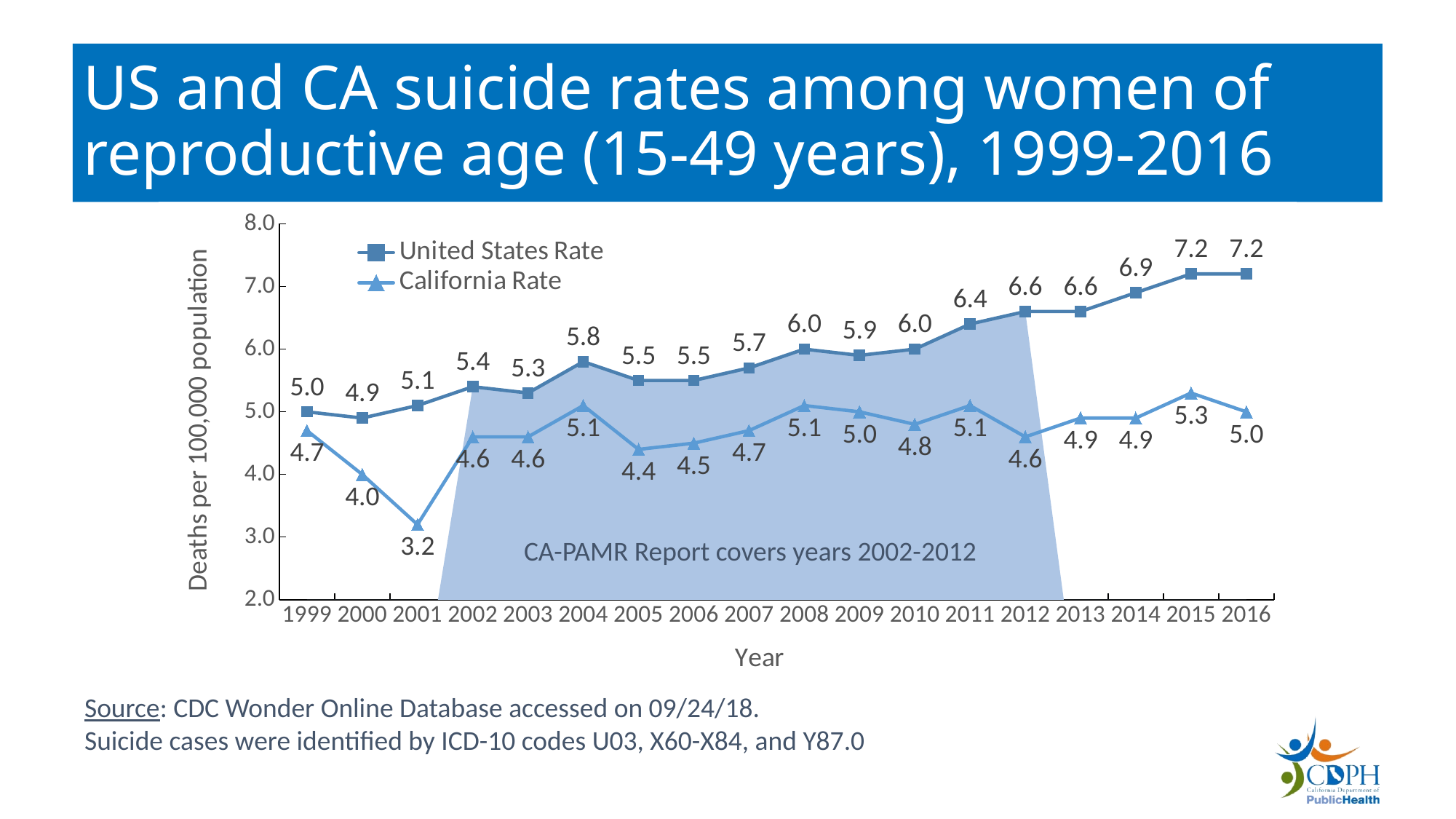
Which was higher in 2004, the United States rate or the California rate? United States Rate What was the California rate in 2001? 3.2 What kind of chart is shown on the slide? Line chart In which year was the California rate lowest? 2001 Does the United States rate generally rise or fall from 1999 to 2016? Rise What was the United States rate in 2008? 6.0 What is the highest United States rate shown on the chart? 7.2 How many series does the legend list? 2 Which years does the shaded area labelled CA-PAMR Report cover? 2002-2012 What was the California rate in 2015? 5.3 How many years are shown on the x axis? 18 What is the difference between the United States rate and the California rate in 2016? 2.2